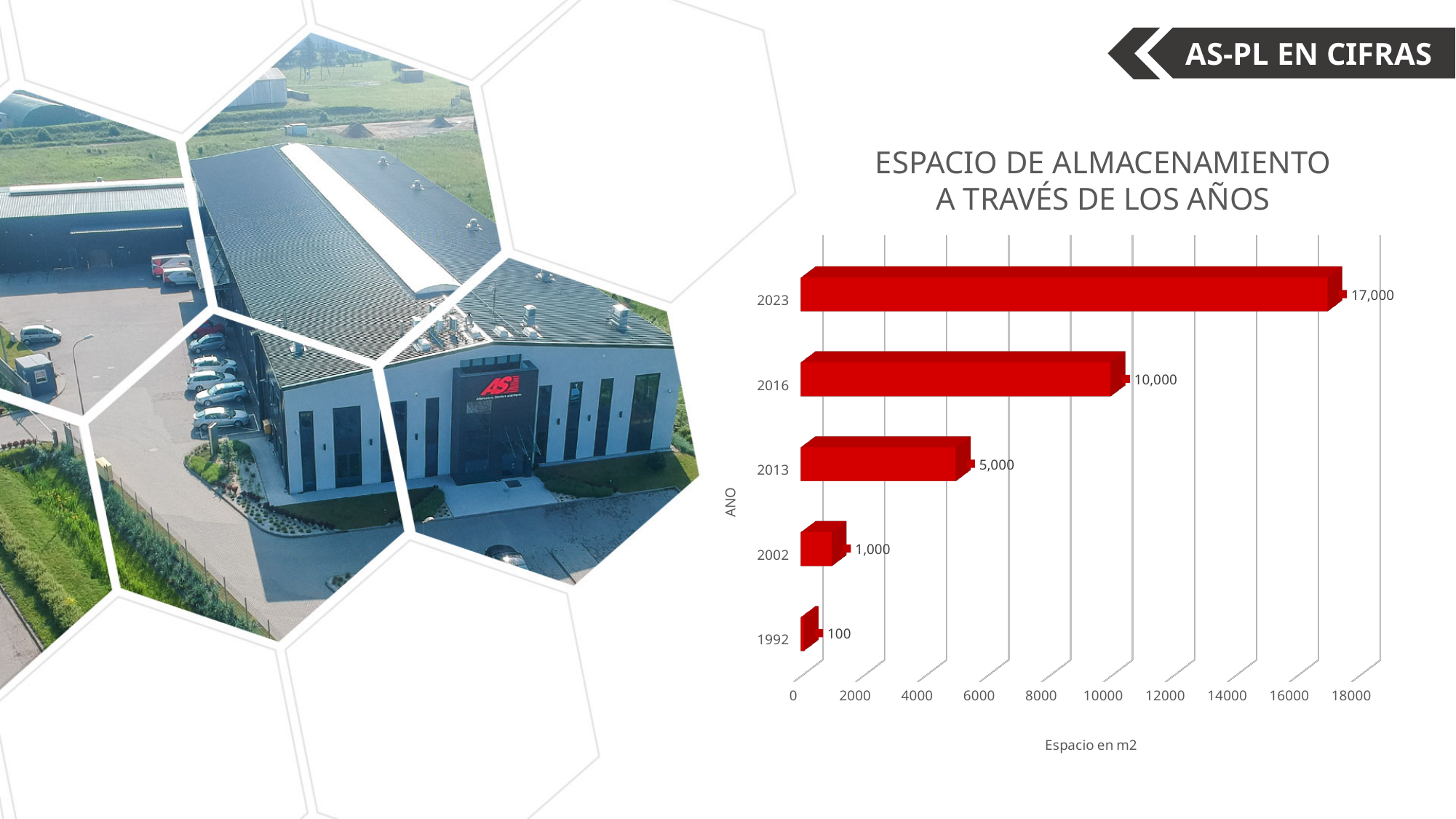
What is the title of the chart? ESPACIO DE ALMACENAMIENTO A TRAVÉS DE LOS AÑOS What is the difference in storage space between 2023 and 2016? 7,000 What is the storage space value for 2013? 5,000 Which year has the highest storage space? 2023 Which year has the lowest storage space? 1992 Which year has a larger storage space, 2013 or 2002? 2013 What is the label of the horizontal axis of the chart? Espacio en m2 What is the storage space value for 1992? 100 How many years are shown in the chart? 5 What is the storage space value for 2023? 17,000 What kind of chart is shown on the slide? Bar chart What is the storage space value for 2016? 10,000